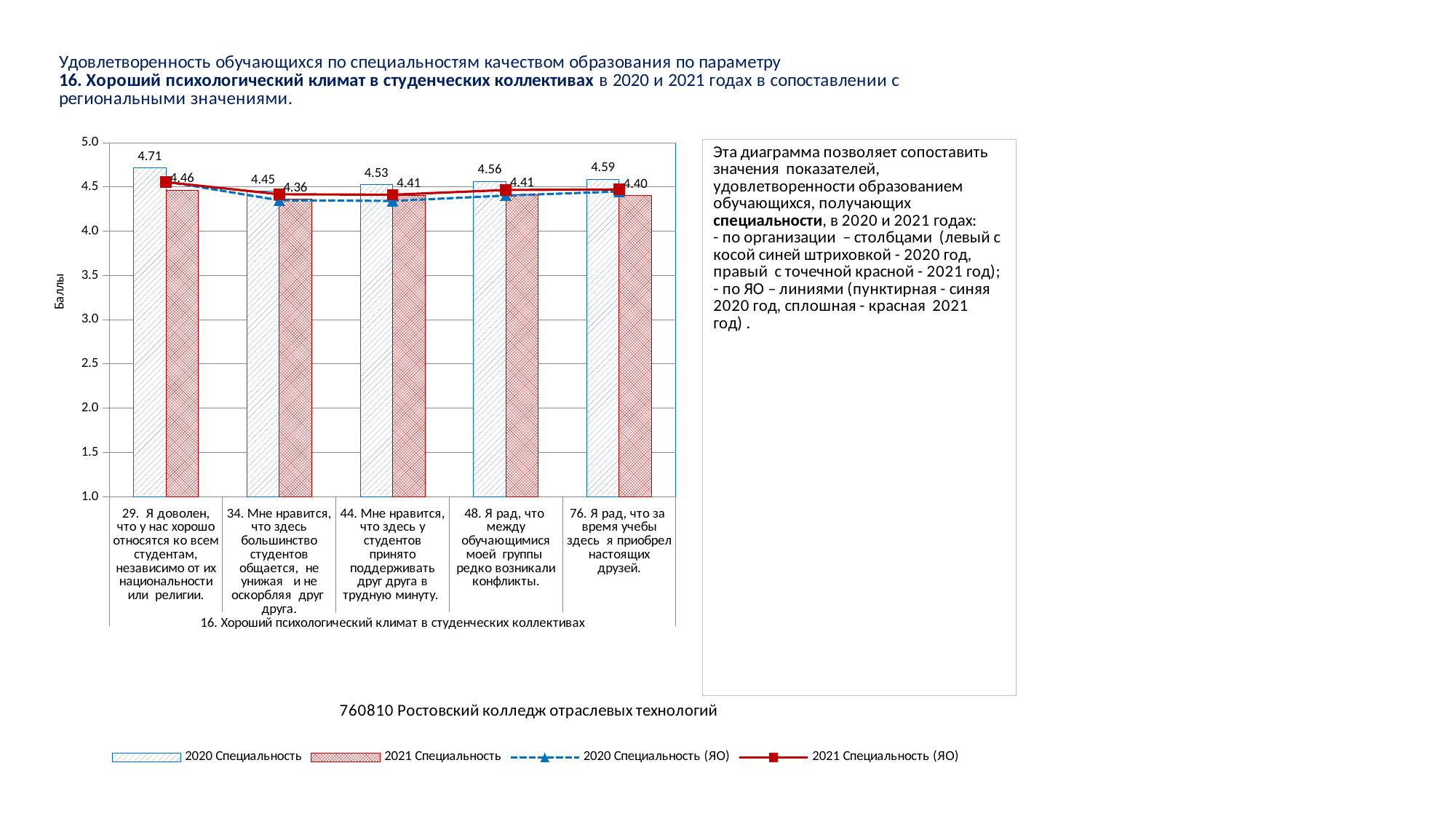
Is the 2020 Специальность (ЯО) line value for category 34 greater or less than 4.5? less What is the 2021 Специальность value for category 76 (Я рад, что за время учебы здесь я приобрел настоящих друзей)? 4.40 What is the 2020 Специальность value for category 29 (Я доволен, что у нас хорошо относятся ко всем студентам...)? 4.71 Which category has the lowest 2020 Специальность value? 34. Мне нравится, что здесь большинство студентов общается, не унижая и не оскорбляя друг друга. What is the difference between the 2020 and 2021 Специальность values for category 29? 0.25 What is the label of the y axis? Баллы How many categories are shown on the x axis? 5 Which category has the highest 2020 Специальность value? 29. Я доволен, что у нас хорошо относятся ко всем студентам, независимо от их национальности или религии. How many series does the legend list? 4 What type of chart is used for the Специальность values for 2020 and 2021? bar chart What is the 2021 Специальность value for category 34 (Мне нравится, что здесь большинство студентов общается...)? 4.36 Which is larger for category 48: the 2020 Специальность value or the 2021 Специальность value? 2020 Специальность